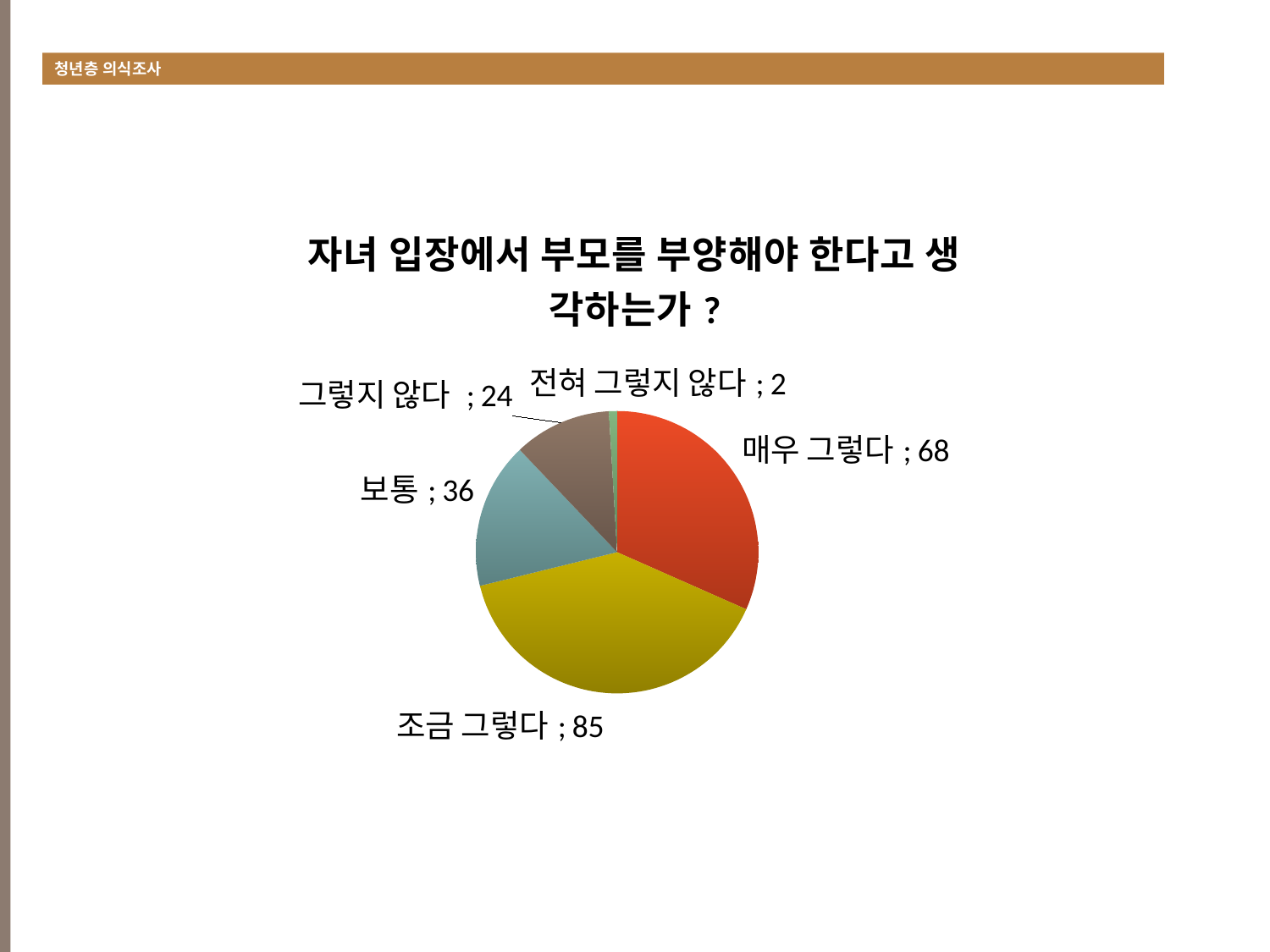
What is the difference between the values for 조금 그렇다 and 매우 그렇다? 17 Which is larger, the value for 보통 or the value for 그렇지 않다? 보통 What is the value for 전혀 그렇지 않다? 2 What is the value for 매우 그렇다? 68 What type of chart is shown on the slide? pie chart Which category has the largest slice? 조금 그렇다 What is the title of the chart? 자녀 입장에서 부모를 부양해야 한다고 생각하는가 ? What is the total of all the slice values? 215 Which category has the smallest slice? 전혀 그렇지 않다 What is the value for 조금 그렇다? 85 What is the value for 보통? 36 How many categories are shown in the pie chart? 5